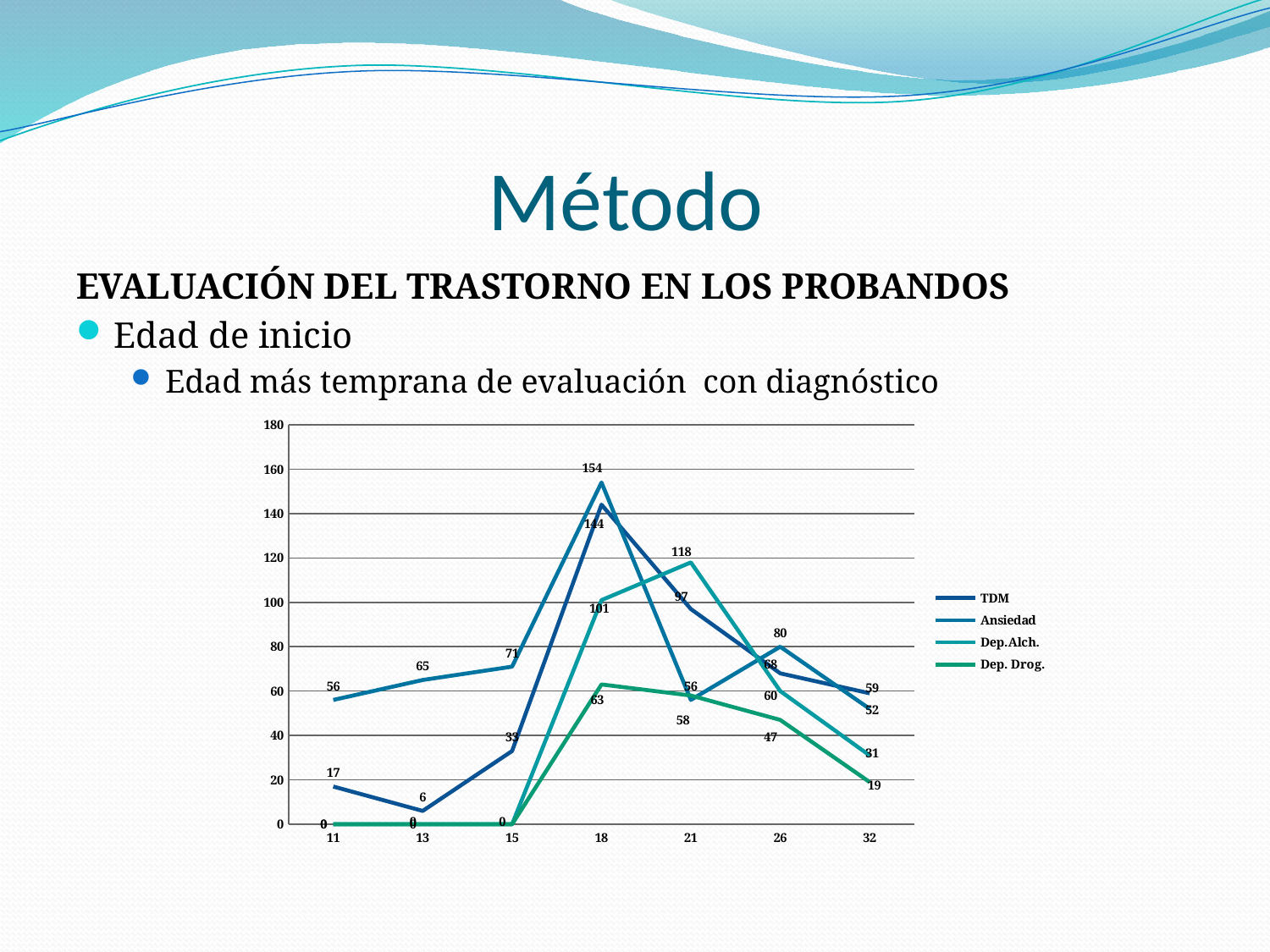
How many series does the legend list? 4 At 26, which series has the larger value, Ansiedad or TDM? Ansiedad At which x-axis value is the TDM series lowest? 13 What is the value of the Dep.Alch. series at 21? 118 Does the Dep. Drog. series rise or fall from 18 to 32? fall What is the value of the Ansiedad series at 18? 154 What is the value of the TDM series at 21? 97 Which series is shown in green in the legend? Dep. Drog. What is the difference between the Ansiedad value and the TDM value at 18? 10 What type of chart is shown on the slide? line chart How many points are plotted along the x axis for each series? 7 At which x-axis value does the TDM series reach its highest point? 18